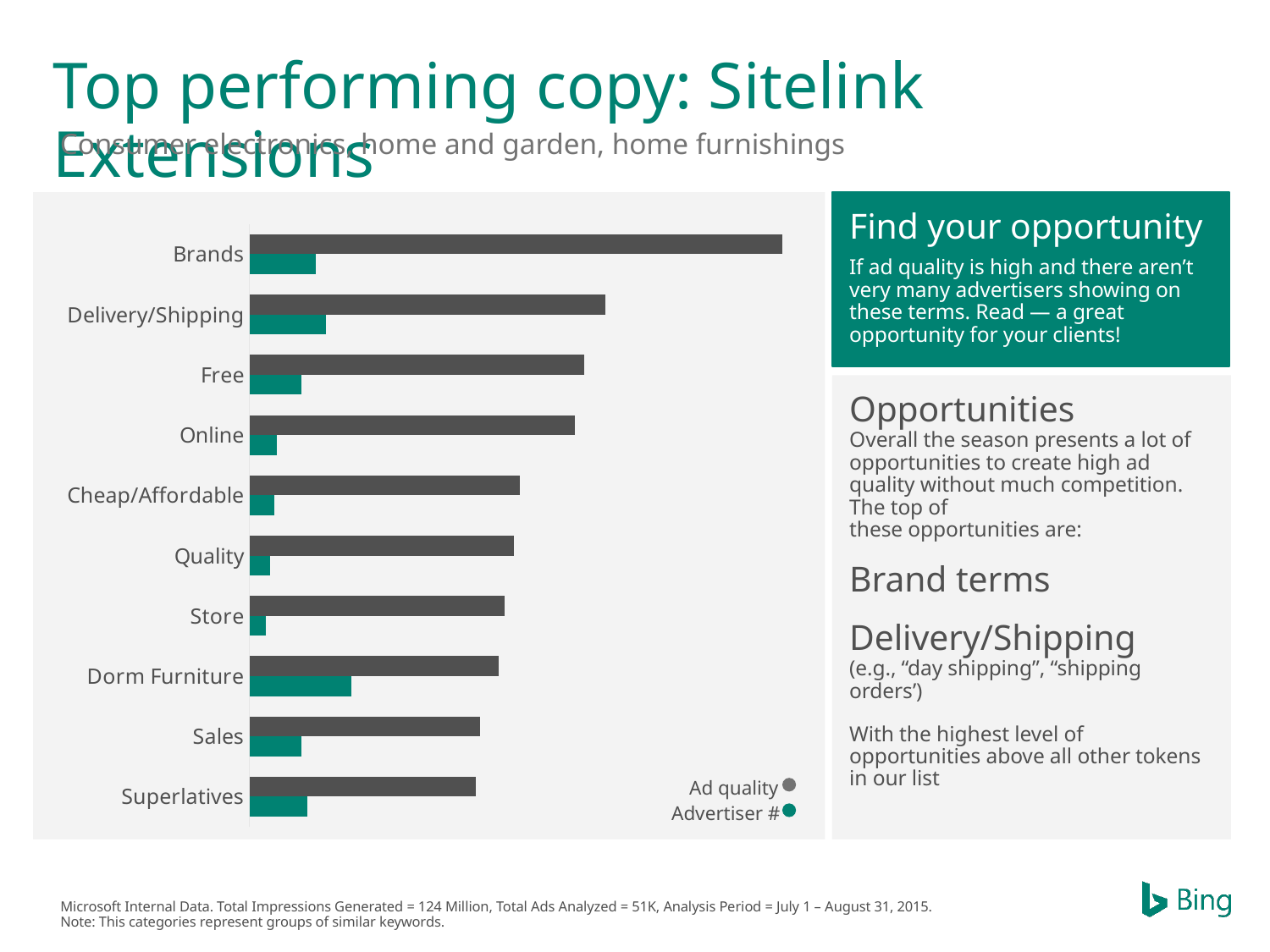
What are the two series named in the chart's legend? Ad quality and Advertiser # Which has the larger Ad quality value, Brands or Superlatives? Brands Which has the larger Advertiser # value, Dorm Furniture or Store? Dorm Furniture Which category has the highest Ad quality value? Brands What kind of chart is shown on the slide? Bar chart Do the Ad quality bars generally get longer or shorter going from the top category to the bottom category? Shorter How many categories are plotted on the chart? 10 What colour are the Advertiser # bars? Teal Which category has the highest Advertiser # value? Dorm Furniture How many series does the chart's legend list? 2 Which has the larger Advertiser # value, Brands or Online? Brands